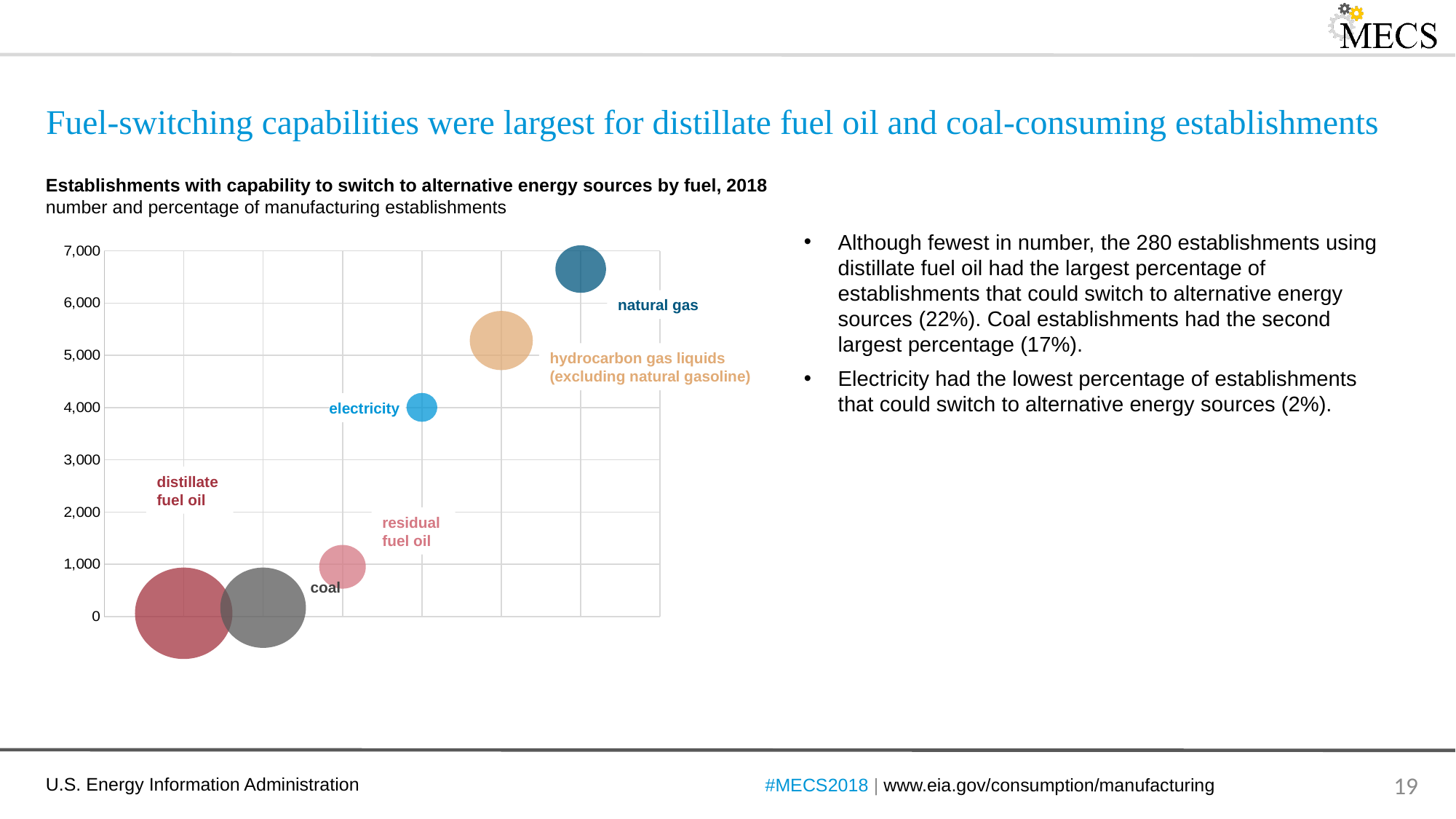
Which has more establishments on the vertical axis, natural gas or residual fuel oil? natural gas Which fuel has the highest position on the vertical axis (number of establishments)? natural gas Is the number of establishments for electricity greater or less than 3,000? greater Which fuel is represented by the largest bubble in the chart? distillate fuel oil Is the number of establishments for coal greater or less than 1,000? less Is the number of establishments for hydrocarbon gas liquids (excluding natural gasoline) greater or less than 5,000? greater Which fuel has the lowest position on the vertical axis (number of establishments)? distillate fuel oil According to the slide text, what percentage of distillate fuel oil establishments could switch to alternative energy sources? 22% How many fuel categories are plotted as bubbles in the chart? 6 What type of chart is shown on the slide? bubble chart What is the title of the chart? Establishments with capability to switch to alternative energy sources by fuel, 2018